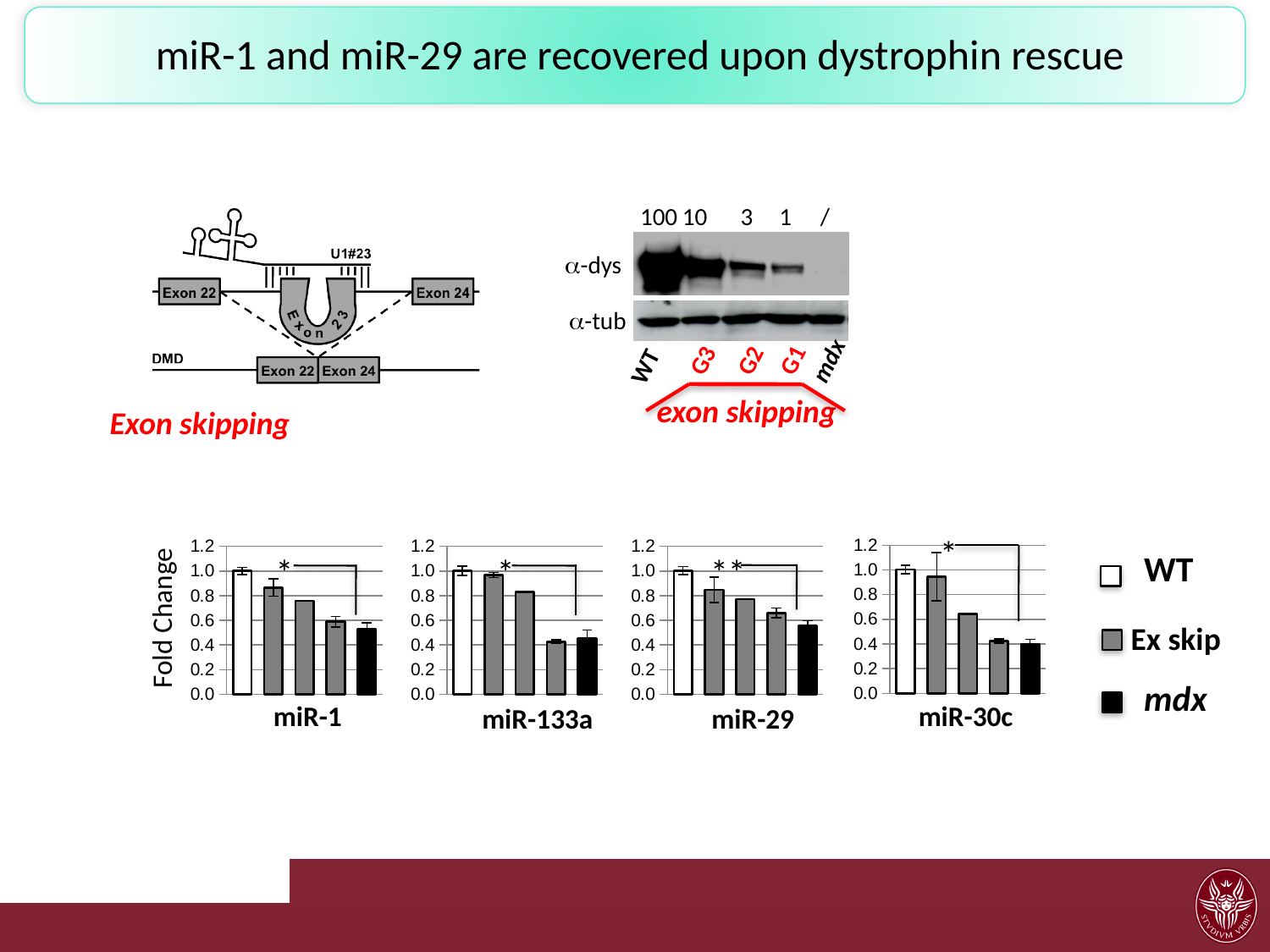
In the miR-1 chart, which is larger, the WT bar or the mdx bar? WT What is the y-axis label of the bar charts? Fold Change In the miR-133a chart, is the value for mdx greater or less than 0.6? less How many bars are plotted in the miR-29 chart? 5 In the miR-29 chart, do the bar values rise or fall from left to right? fall What kind of chart is used for the miR-1 panel? bar chart In the miR-29 chart, which bar is the lowest? mdx In the miR-30c chart, is the value for mdx greater or less than 0.6? less In the miR-1 chart, is the value for mdx greater or less than 0.8? less How many series does the legend next to the bar charts list? 3 In the miR-29 chart, which bar is the highest? WT Which legend entry is shown with a black fill? mdx